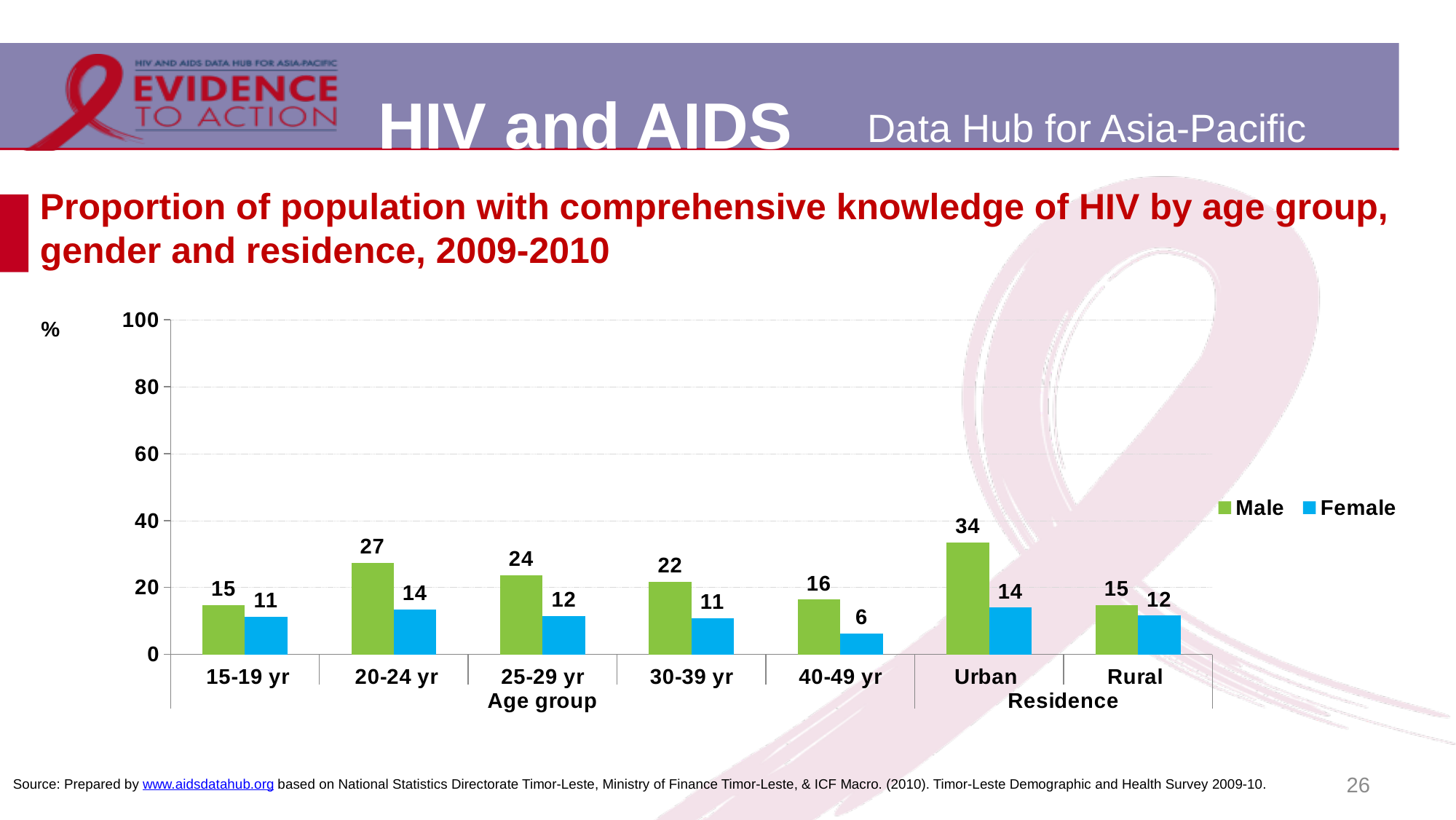
What is the Male value for Urban residence? 34 Which category has the lowest Female value? 40-49 yr What is the difference between the Male and Female values for the 25-29 yr age group? 12 How many series does the legend list? 2 Which is larger, the Male value for Urban or the Male value for Rural? Urban Which colour represents the Female series? Blue Which category has the highest Male value? Urban What is the Female value for the 40-49 yr age group? 6 What is the Male value for the 20-24 yr age group? 27 What kind of chart is shown on the slide? Bar chart Is the Male value for Urban greater or less than 40? less How many categories are shown on the x axis? 7